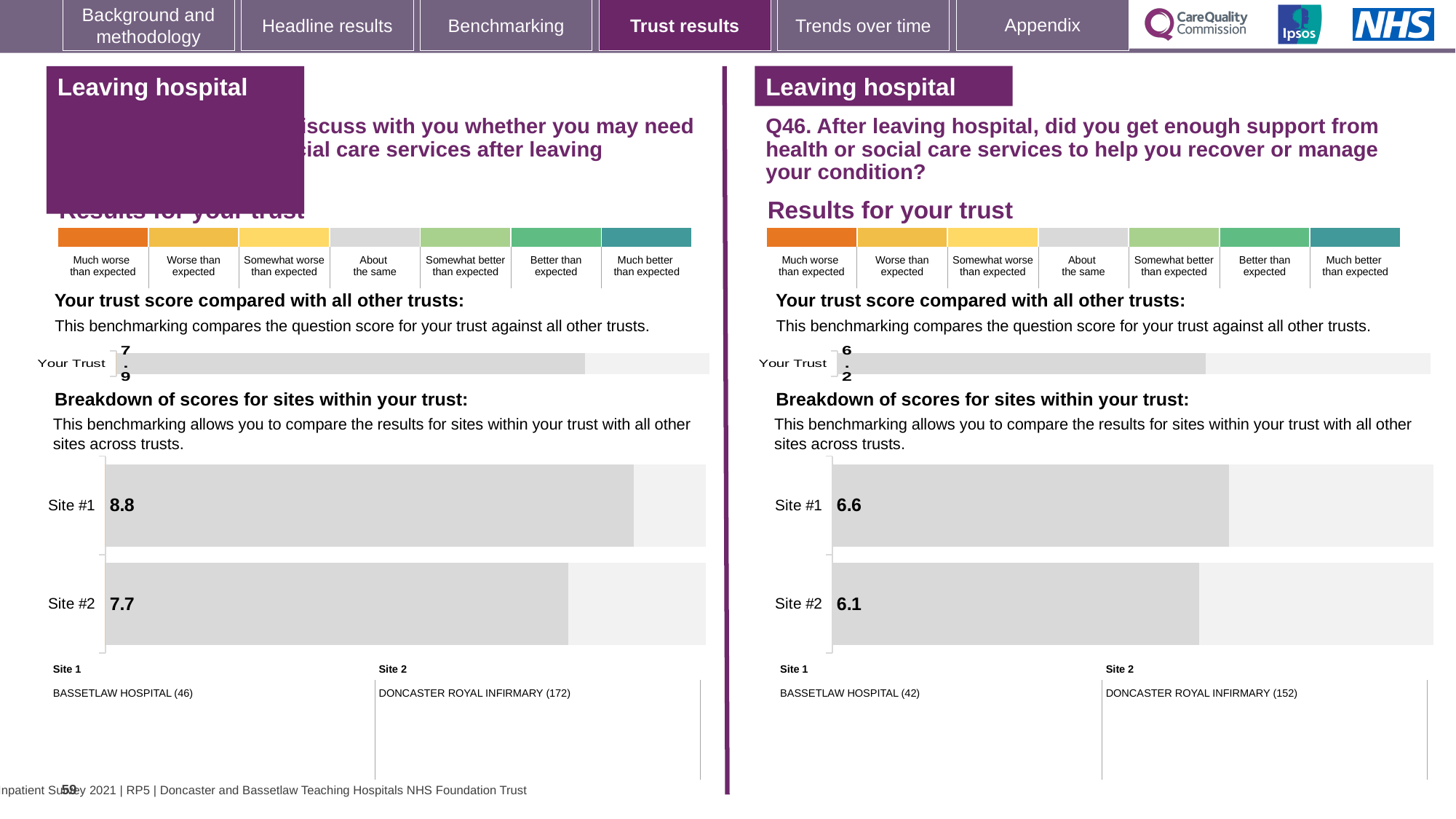
On the right-hand (Q46) 'Breakdown of scores for sites within your trust' chart, what is the score for Site #2? 6.1 On the left-hand 'Breakdown of scores for sites within your trust' chart, what is the score for Site #2? 7.7 How many sites are shown on the right-hand (Q46) site breakdown chart? 2 On the right-hand (Q46) 'Breakdown of scores for sites within your trust' chart, what is the score for Site #1? 6.6 On the right-hand (Q46) site breakdown chart, what is the difference between the Site #1 and Site #2 scores? 0.5 What type of chart is the left-hand 'Breakdown of scores for sites within your trust' chart? Bar chart On the left-hand site breakdown chart, what is the difference between the Site #1 and Site #2 scores? 1.1 On the left-hand site breakdown chart, which site has the higher score? Site #1 On the right-hand (Q46) site breakdown chart, which site has the lower score? Site #2 On the left-hand 'Breakdown of scores for sites within your trust' chart, what is the score for Site #1? 8.8 On the right-hand (Q46) 'Your trust score compared with all other trusts' chart, what is the score shown for Your Trust? 6.2 On the left-hand 'Your trust score compared with all other trusts' chart, what is the score shown for Your Trust? 7.9